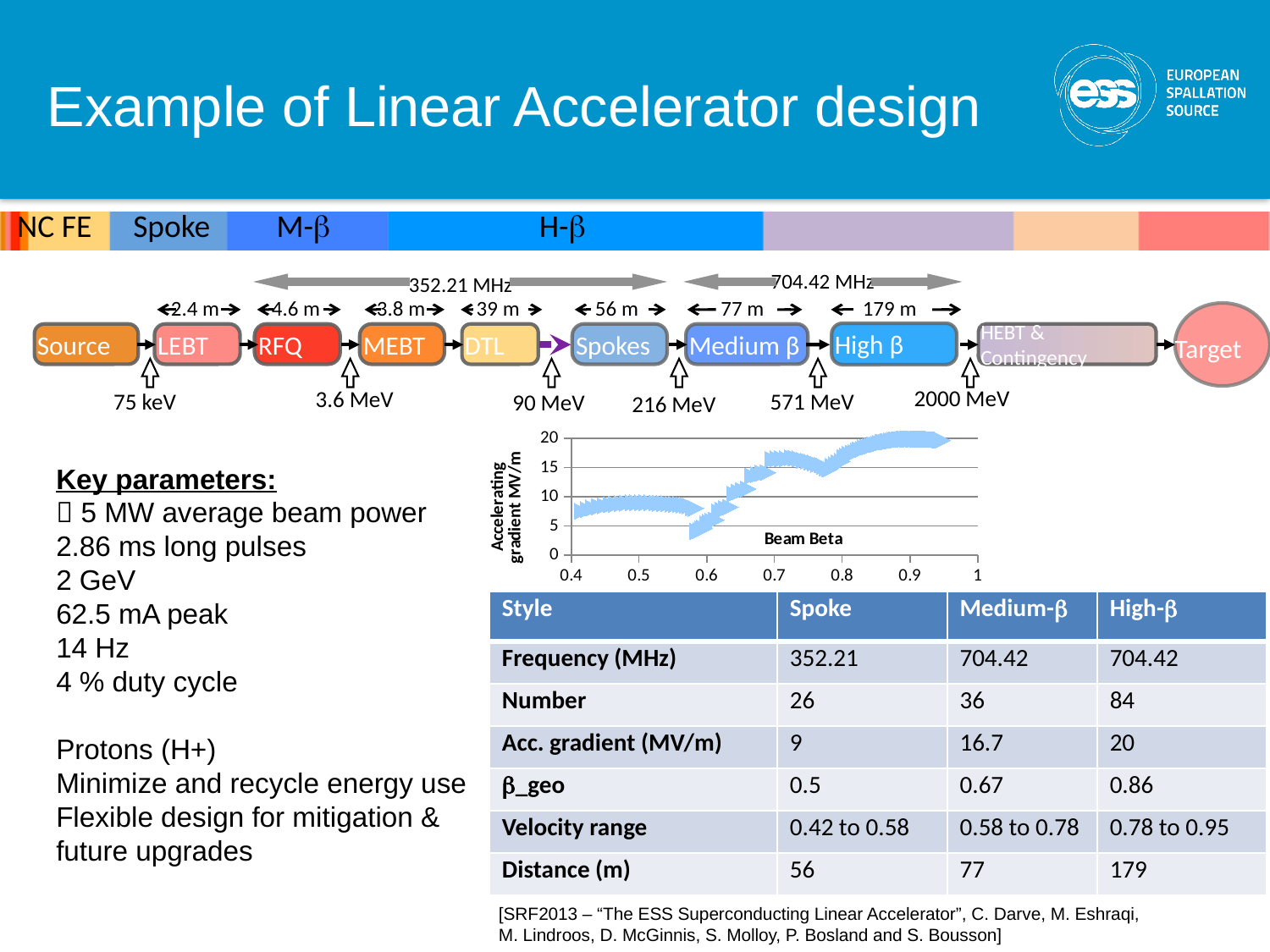
Overall, does the accelerating gradient rise or fall as beam beta increases from 0.4 to 1? rise Is the accelerating gradient higher at a beam beta of 0.9 or at a beam beta of 0.5? 0.9 Is the accelerating gradient at a beam beta of 0.95 greater or less than 10 MV/m? greater What is the highest tick value shown on the y axis of the chart? 20 What is the label of the x axis of the chart? Beam Beta Is the accelerating gradient at a beam beta of 0.5 greater or less than 5 MV/m? greater What kind of chart is shown on the slide? scatter chart Is the accelerating gradient at a beam beta of 0.9 greater or less than 15 MV/m? greater What is the label of the y axis of the chart? Accelerating gradient MV/m